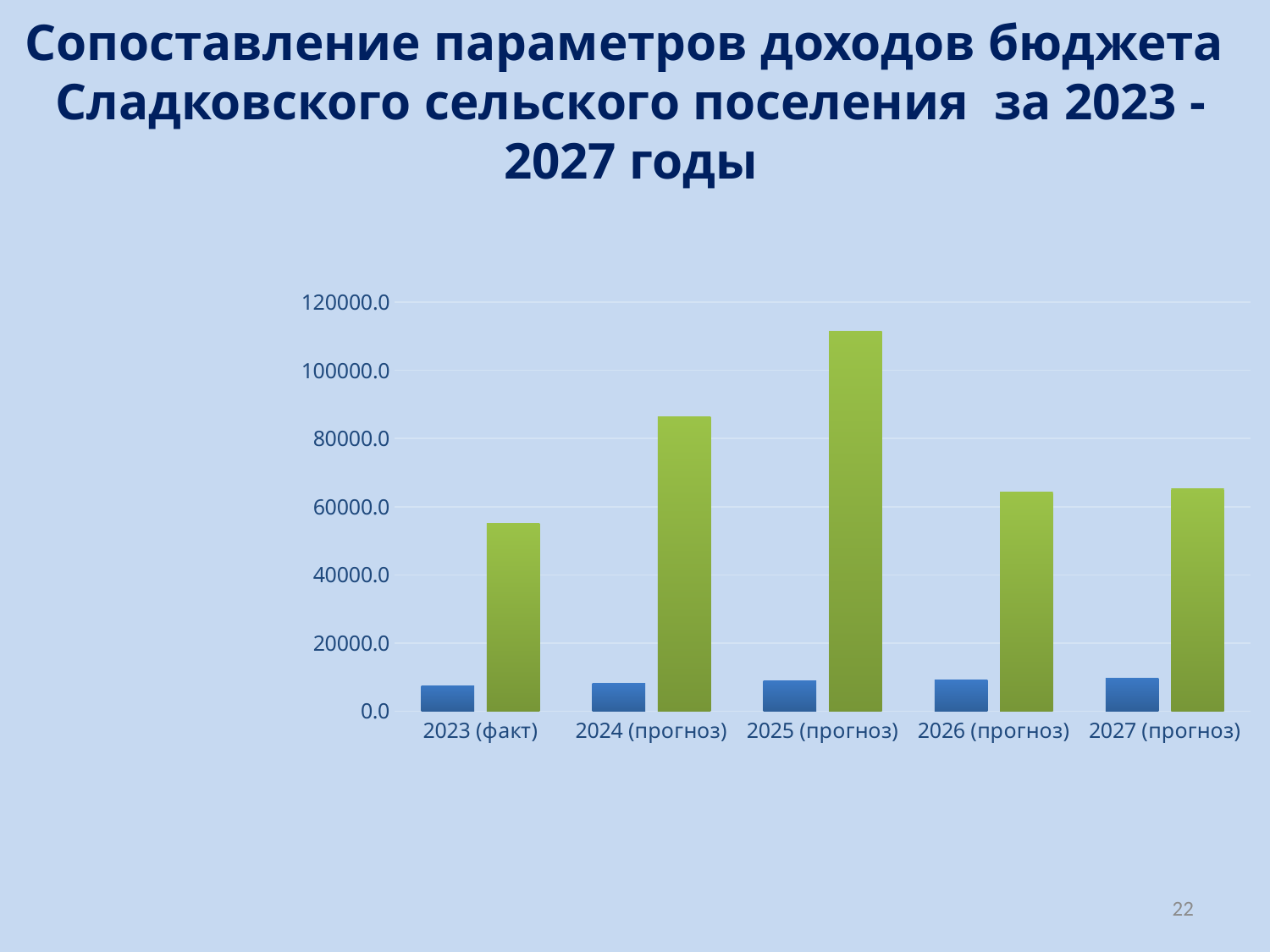
What is the title of the slide containing the chart? Сопоставление параметров доходов бюджета Сладковского сельского поселения за 2023 - 2027 годы What kind of chart is shown on the slide? bar chart What two colours are used for the bars in the chart? blue and green Do the green bars rise or fall from 2023 (факт) to 2025 (прогноз)? rise Is the green bar for 2024 (прогноз) greater or less than 80000.0? greater Which green bar is taller: 2024 (прогноз) or 2026 (прогноз)? 2024 (прогноз) Is the green bar for 2025 (прогноз) greater or less than 100000.0? greater Is the blue bar for 2025 (прогноз) greater or less than 20000.0? less Which category has the shortest green bar? 2023 (факт) Which category has the tallest green bar? 2025 (прогноз) How many categories are shown on the x axis of the chart? 5